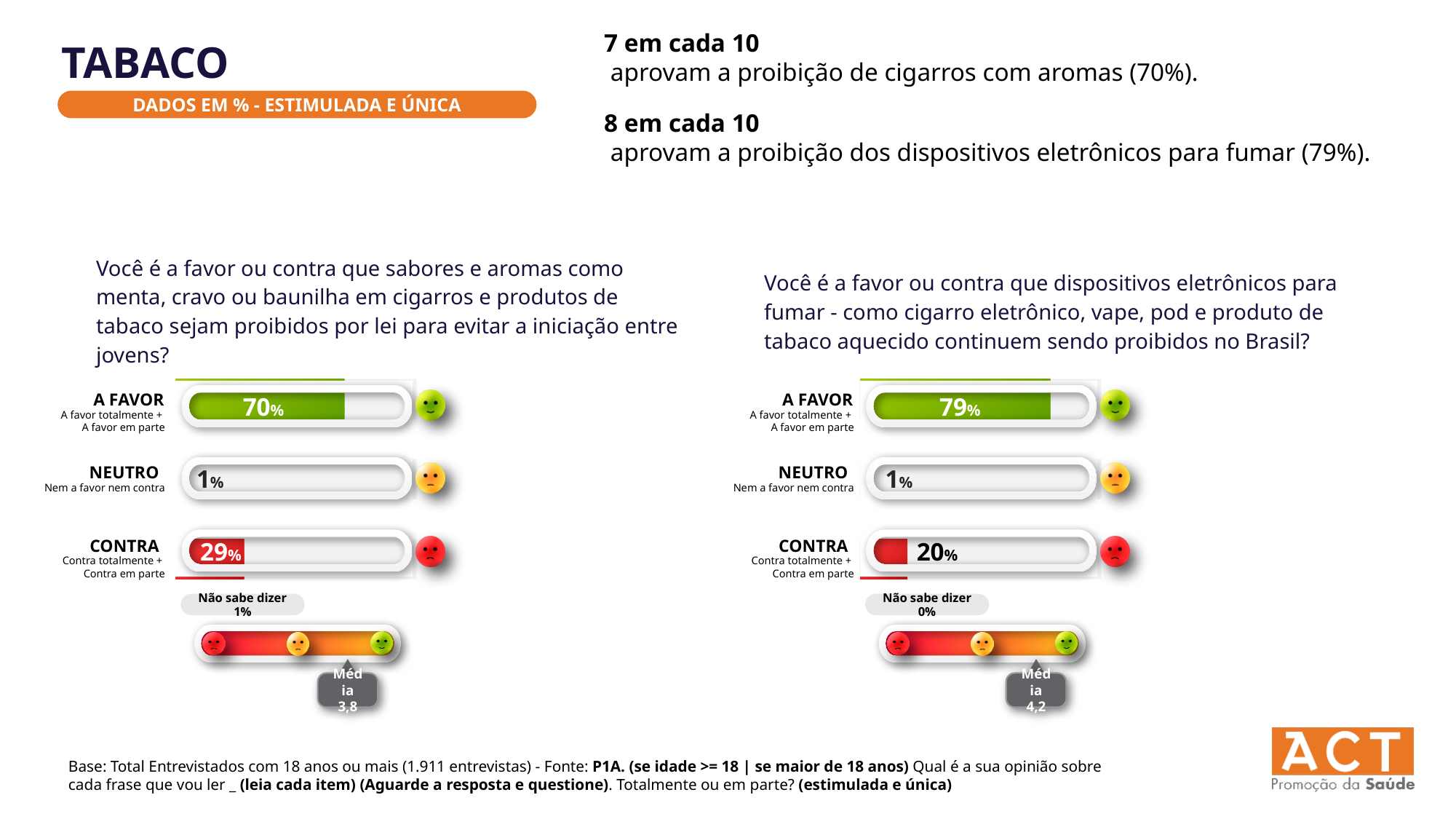
In the right chart, what is the value for CONTRA? 20% In the right chart (about electronic smoking devices), what is the value for A FAVOR? 79% In the right chart, what is the value shown for Não sabe dizer? 0% What kind of chart is used on the left side of the slide? Bar chart In the left chart (about flavored cigarettes), what is the value for A FAVOR? 70% What is the Média value shown under the right chart? 4,2 In the left chart, which category has the highest value? A FAVOR In the left chart, what is the value for CONTRA? 29% In the left chart, what is the value for NEUTRO? 1% In the left chart, what is the difference between A FAVOR and CONTRA? 41% Which is larger: CONTRA in the left chart or CONTRA in the right chart? CONTRA in the left chart In the right chart, which category has the lowest value among A FAVOR, NEUTRO and CONTRA? NEUTRO